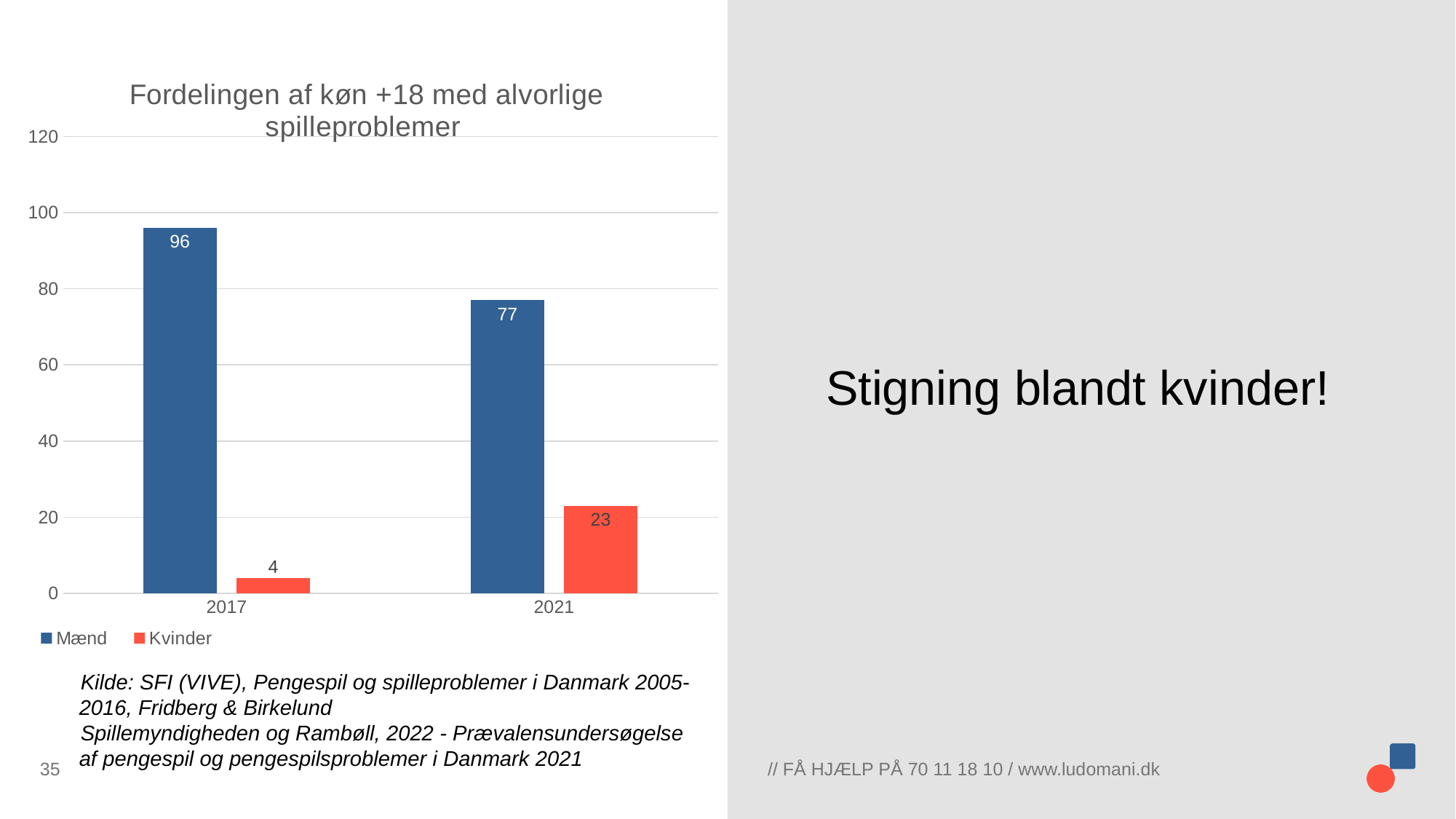
What is the value for Kvinder in 2017? 4 Which year has the highest value for Mænd? 2017 What is the difference between the Mænd values in 2017 and 2021? 19 What is the difference between Mænd and Kvinder in 2021? 54 Which year has the lowest value for Kvinder? 2017 What is the value for Mænd in 2017? 96 Does the value for Kvinder rise or fall from 2017 to 2021? Rise What is the value for Mænd in 2021? 77 How many series does the legend list? 2 What is the value for Kvinder in 2021? 23 What kind of chart is shown on the slide? Bar chart Which is larger in 2021, Mænd or Kvinder? Mænd